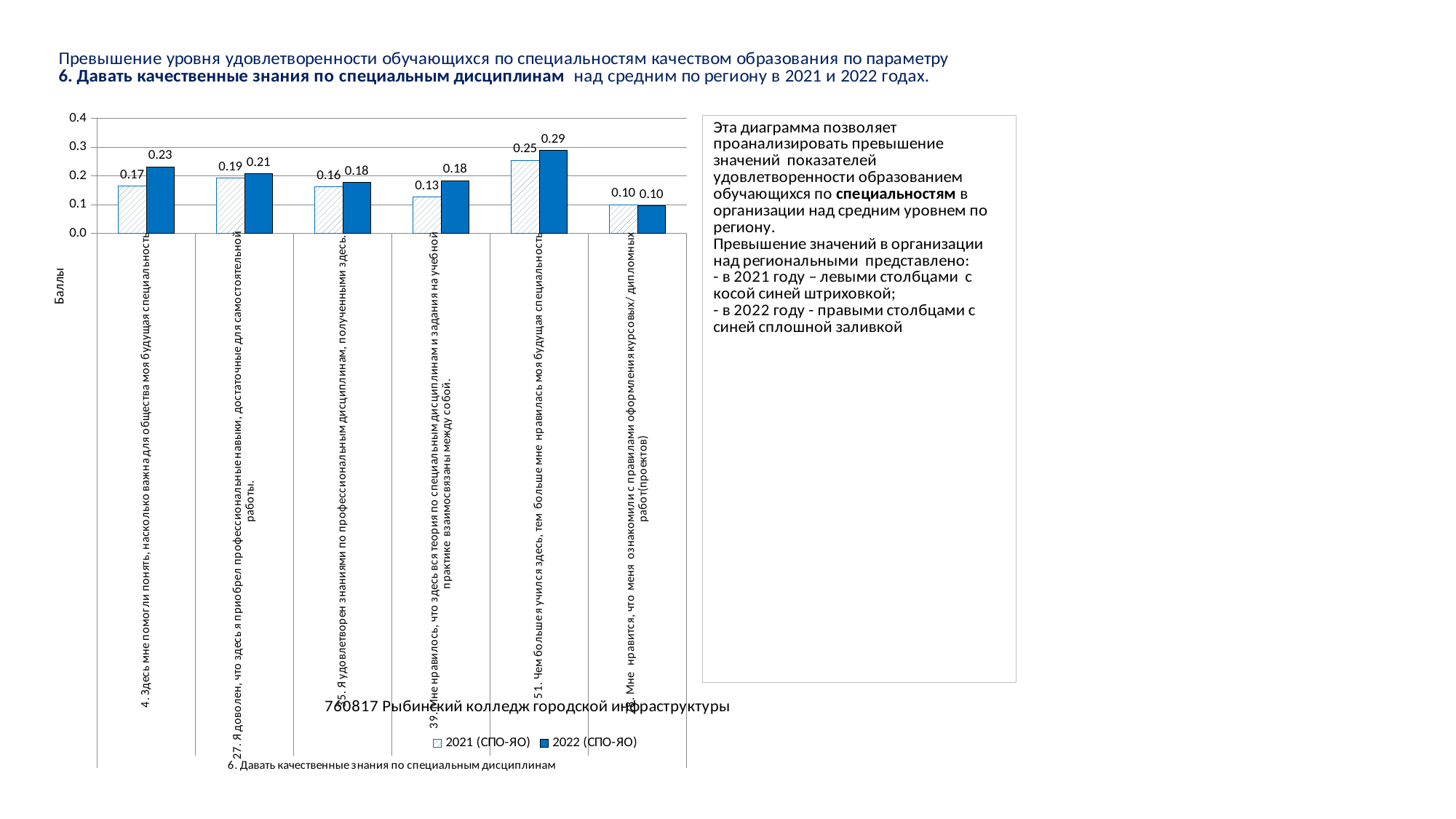
What is the 2022 (СПО-ЯО) value for statement 4 ("Здесь мне помогли понять, насколько важна для общества моя будущая специальность")? 0.23 How many categories (statements) are plotted on the chart? 6 Which statement has the lowest 2021 (СПО-ЯО) value? Мне нравится, что меня ознакомили с правилами оформления курсовых/дипломных работ(проектов) What type of chart is shown on the slide? bar chart What is the difference between the 2022 and 2021 values for statement 4? 0.06 What is the 2021 (СПО-ЯО) value for statement 27 ("Я доволен, что здесь я приобрел профессиональные навыки, достаточные для самостоятельной работы")? 0.19 What is the difference between the 2022 and 2021 values for statement 51? 0.04 Which statement has the highest 2022 (СПО-ЯО) value? 51. Чем больше я учился здесь, тем больше мне нравилась моя будущая специальность Which is larger for statement 35 ("Я удовлетворен знаниями по профессиональным дисциплинам, полученными здесь"): the 2021 value or the 2022 value? 2022 What label is shown on the vertical axis of the chart? Баллы What is the 2021 (СПО-ЯО) value for statement 39 ("Мне нравилось, что здесь вся теория по специальным дисциплинам и задания на учебной практике взаимосвязаны между собой")? 0.13 How many series does the legend list? 2